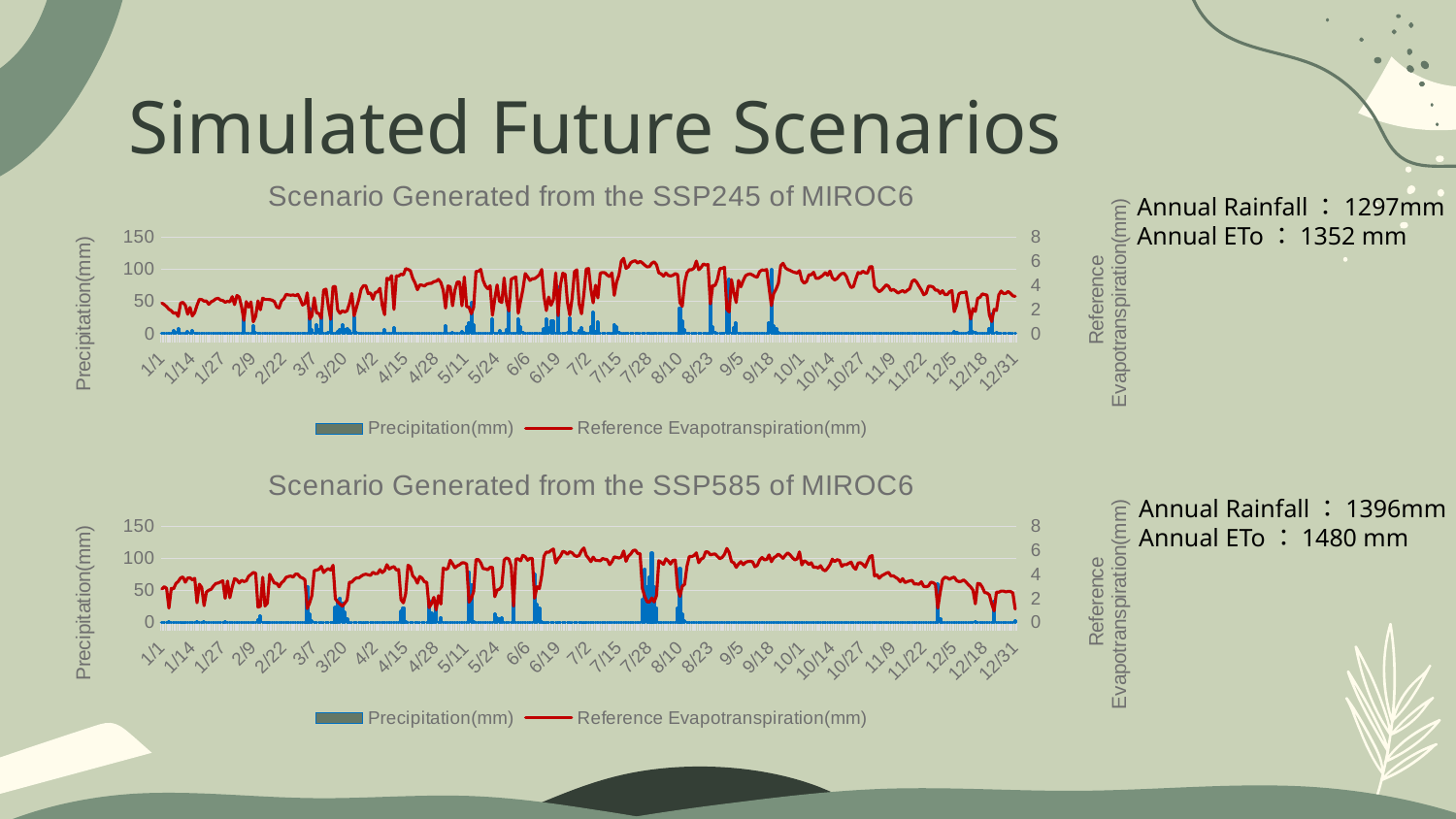
In the top chart (SSP245), is the Reference Evapotranspiration(mm) value around 7/2 greater or less than 4 on the right axis? greater In the chart titled 'Scenario Generated from the SSP585 of MIROC6', how many series does the legend list? 2 How many charts are shown on the slide? 2 What kind of chart is the top chart, 'Scenario Generated from the SSP245 of MIROC6'? A combined bar and line chart In the top chart (SSP245), does the Reference Evapotranspiration(mm) line generally rise or fall from 9/18 to 12/31? fall In the chart titled 'Scenario Generated from the SSP245 of MIROC6', how many series does the legend list? 2 In the top chart, which series is drawn as a red line? Reference Evapotranspiration(mm) In the top chart (SSP245), what is the highest value shown on the left vertical axis? 150 In the bottom chart (SSP585), what is the highest value shown on the right vertical axis? 8 In the top chart (SSP245), is the tallest Precipitation(mm) bar greater or less than 150 on the left axis? less In the bottom chart (SSP585), does the Reference Evapotranspiration(mm) line generally rise or fall from 1/1 to 7/2? rise In the bottom chart, which series is drawn as bars? Precipitation(mm)